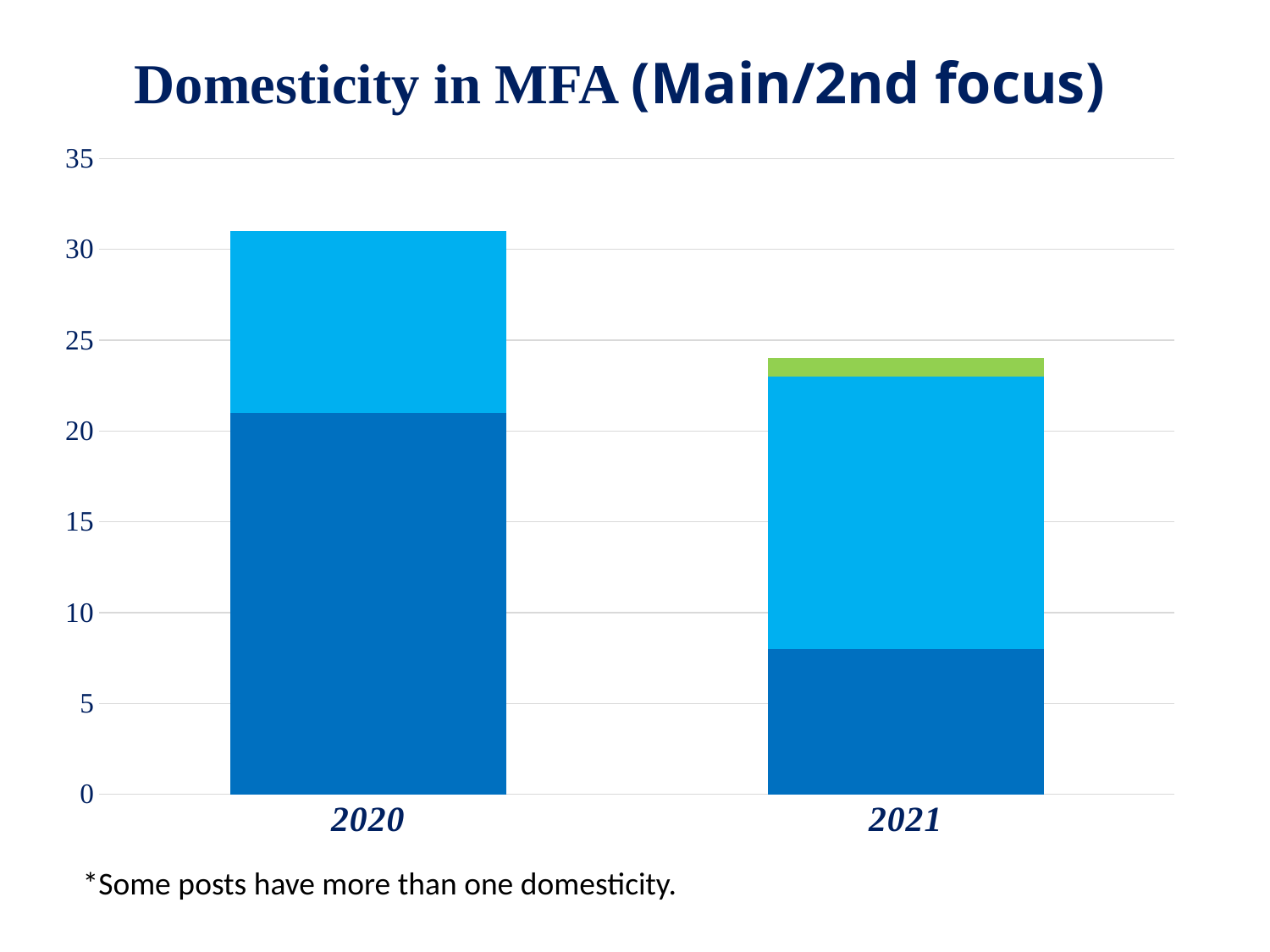
Does the total bar height rise or fall from 2020 to 2021? Fall Which year has the taller total bar, 2020 or 2021? 2020 Which year's bar includes a green segment at the top? 2021 Is the total bar height for 2020 greater or less than 25? greater How many categories (years) are shown on the x axis? 2 Is the dark blue (bottom) segment for 2021 greater or less than 10? less Is the dark blue (bottom) segment for 2020 greater or less than 15? greater What kind of chart is shown on the slide? Stacked bar chart What is the title of the chart? Domesticity in MFA (Main/2nd focus) Which year has the larger dark blue (bottom) segment, 2020 or 2021? 2020